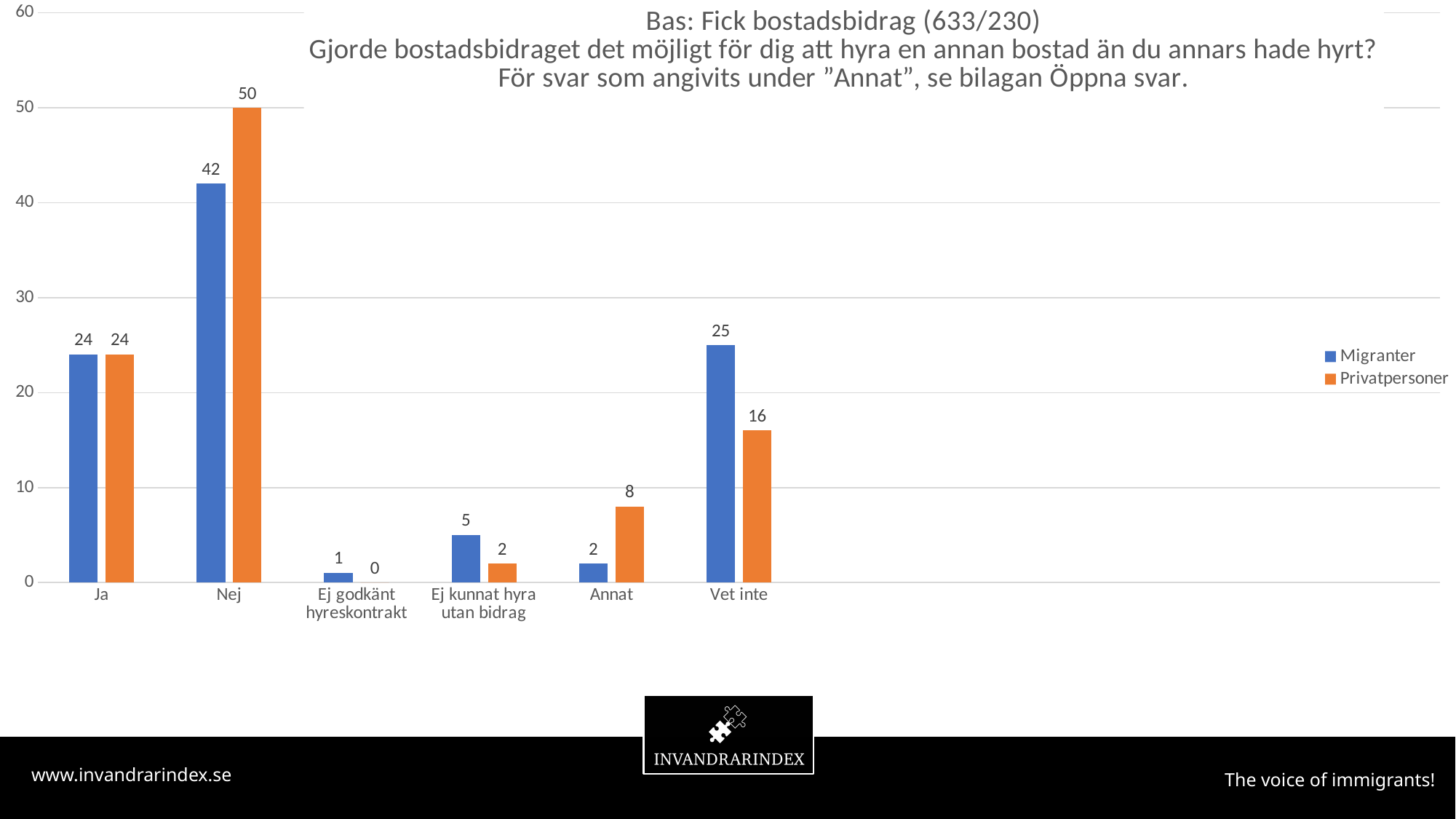
What is the value for Migranter in the Nej category? 42 Which category has the highest value for Privatpersoner? Nej Is the value for Migranter in the Nej category greater or less than 40? greater What kind of chart is shown on the slide? bar chart What is the value for Privatpersoner in the Vet inte category? 16 How many categories are shown on the x axis? 6 How many series does the legend list? 2 What is the difference between the Privatpersoner and Migranter values in the Nej category? 8 Which category has the lowest value for Migranter? Ej godkänt hyreskontrakt Which colour represents Privatpersoner in the legend? orange What is the value for Privatpersoner in the Annat category? 8 Which is larger in the Vet inte category, Migranter or Privatpersoner? Migranter